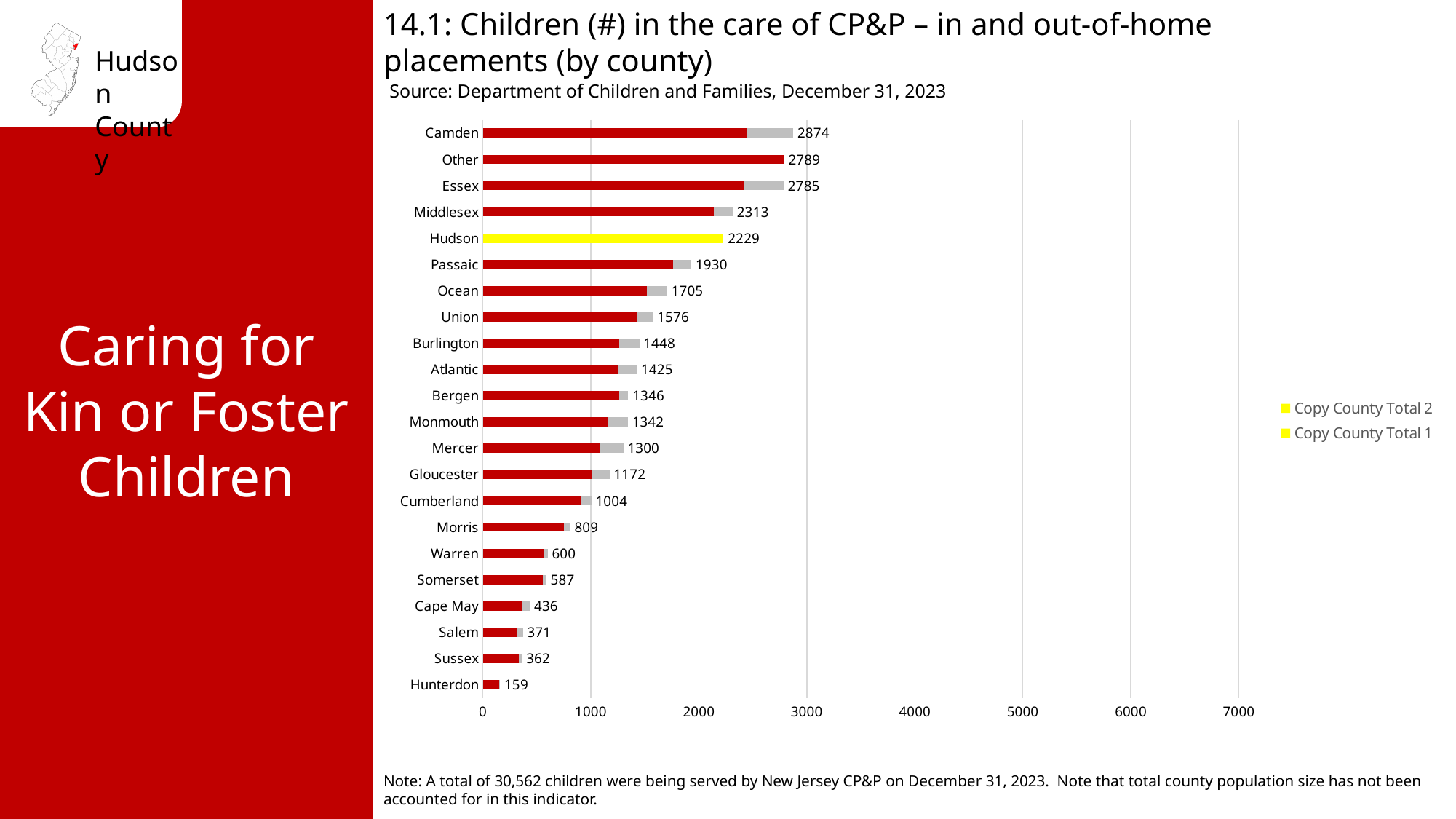
Which county has the highest value on the chart? Camden Which has a larger value, Ocean or Union? Ocean How many series does the legend list? 2 What is the difference between the values for Camden and Hudson? 645 What is the difference between the values for Essex and Middlesex? 472 Which county has the lowest value on the chart? Hunterdon What kind of chart is shown on the slide? bar chart Is the value for Morris greater or less than 1000? less What is the value shown for Hudson? 2229 What is the total number of children in the care of CP&P for Camden? 2874 How many counties (categories) are shown on the chart? 22 What is the value shown for Hunterdon? 159